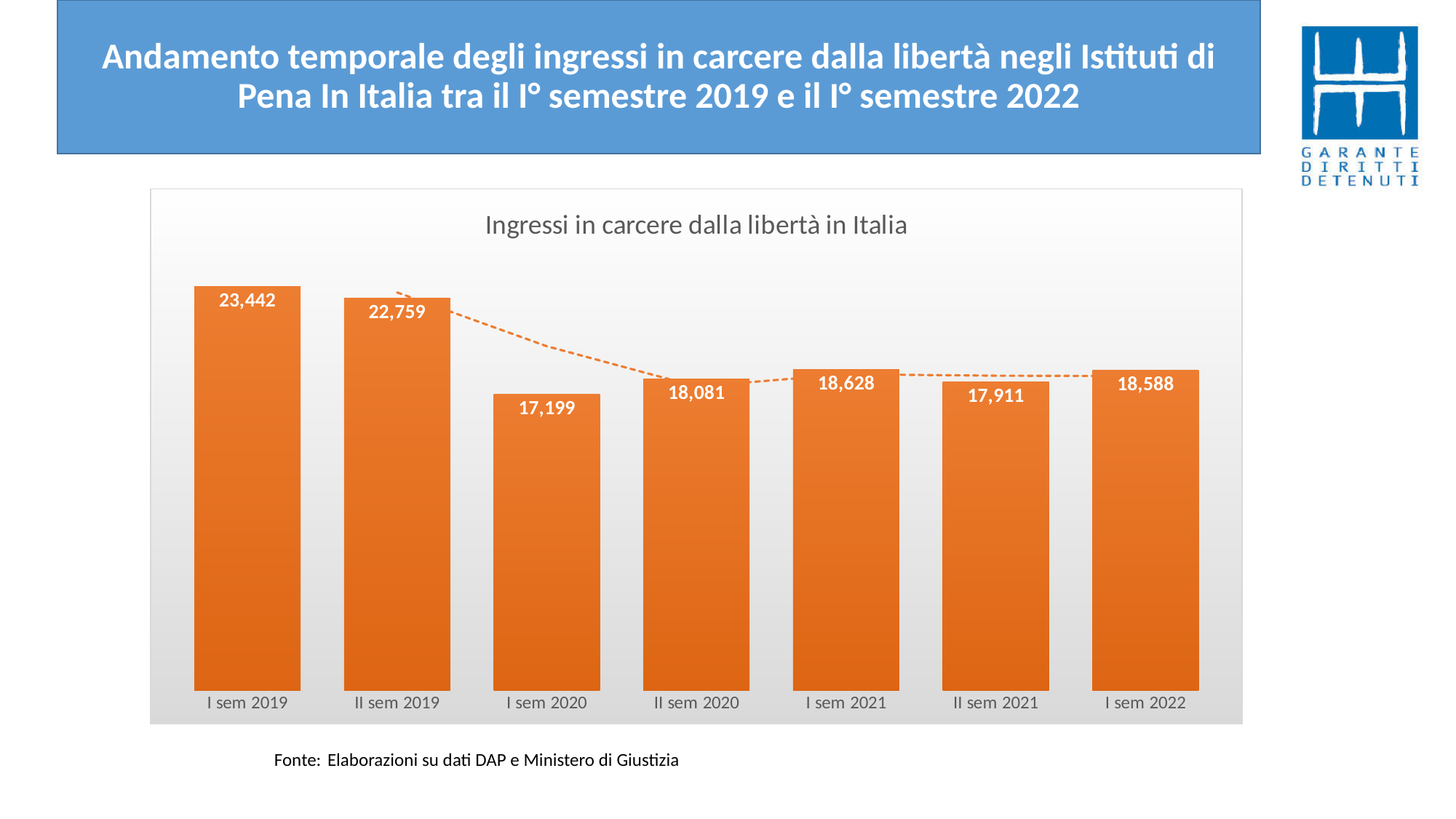
What is the difference between the values for I sem 2019 and II sem 2019? 683 What kind of chart is this? Bar chart Which period has the highest value? I sem 2019 Which period has the lowest value? I sem 2020 Which is larger, the value for II sem 2020 or the value for I sem 2021? I sem 2021 What is the title of the chart? Ingressi in carcere dalla libertà in Italia How many periods are shown on the x axis? 7 What is the value for I sem 2020? 17,199 What is the difference between the values for I sem 2021 and II sem 2021? 717 What is the value for I sem 2019? 23,442 What is the value for II sem 2021? 17,911 What is the value for I sem 2022? 18,588